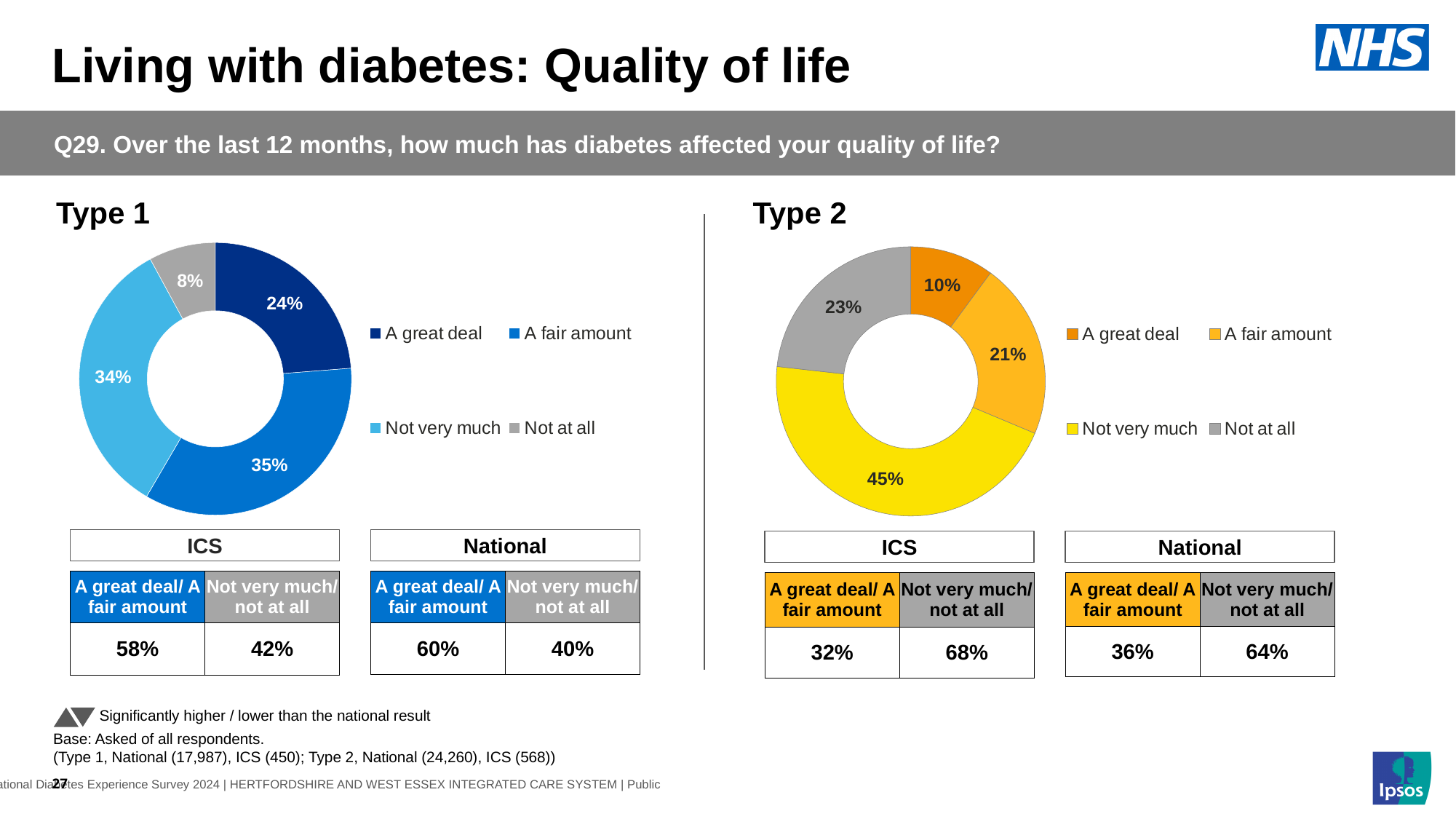
In the Type 2 chart, what percentage of respondents said 'Not very much'? 45% In the Type 2 chart, which response has the smallest share? A great deal In the Type 1 chart, what percentage of respondents said diabetes affected their quality of life 'A fair amount'? 35% In the Type 2 chart, what percentage said 'A great deal'? 10% In the Type 1 chart, which is larger: the share for 'A great deal' or the share for 'Not very much'? Not very much What kind of chart is used to show the Type 1 results? Doughnut chart In the Type 1 chart, what is the combined share of 'A great deal' and 'A fair amount'? 59% In the Type 2 chart, what is the difference in percentage points between 'Not very much' and 'Not at all'? 22 In the Type 2 chart, what colour is the 'Not very much' segment? Yellow How many response categories does the legend of the Type 2 chart list? 4 In the Type 1 chart, what percentage said 'Not at all'? 8% In the Type 1 chart, which response has the largest share? A fair amount